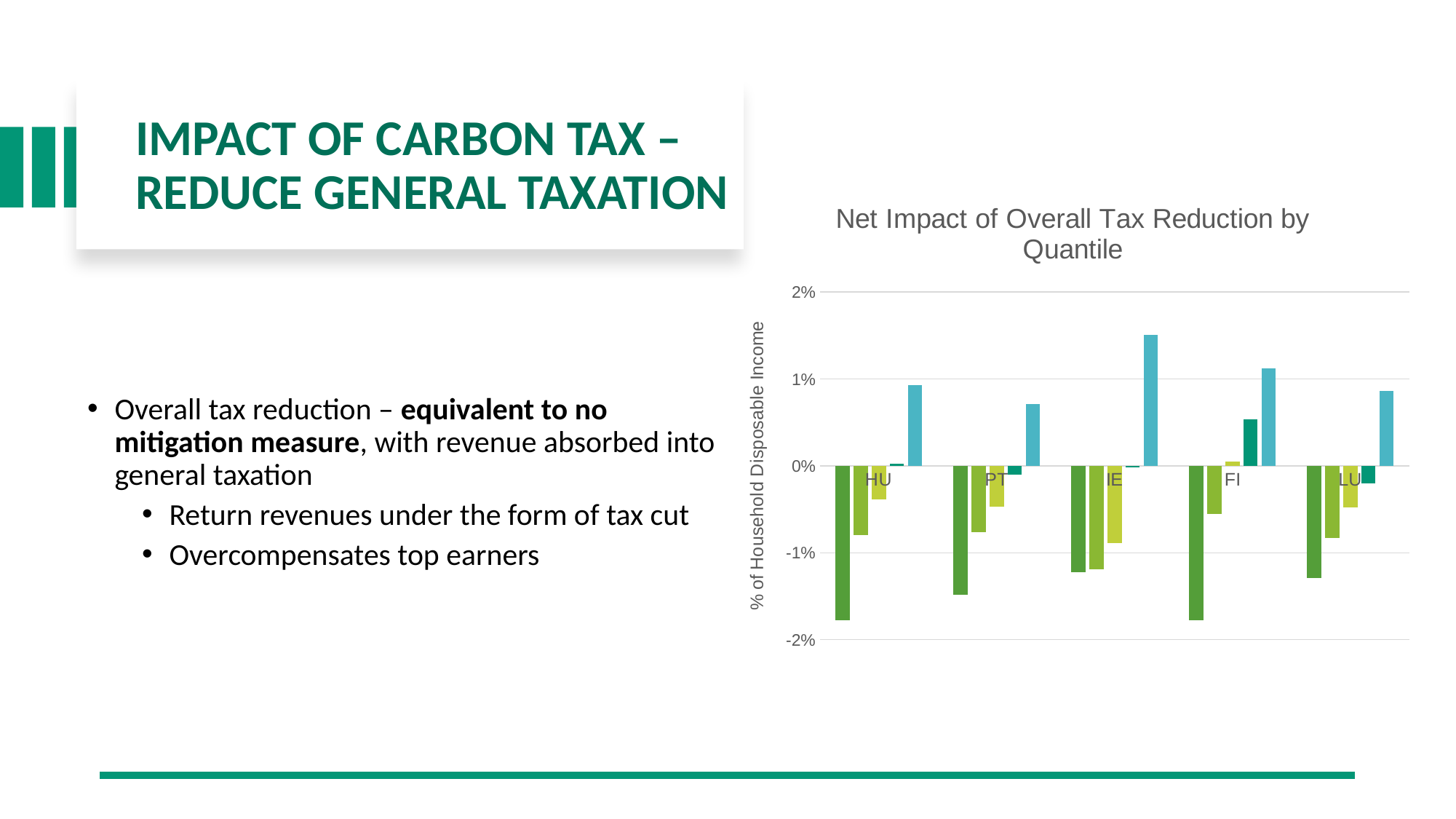
Is the value of the dark green (leftmost) bar for HU greater or less than -1%? less Within the HU group, do the bars rise or fall from left to right? rise What is the label on the vertical axis of the chart? % of Household Disposable Income Which country has the tallest light blue (rightmost) bar? IE Is the value of the light blue (rightmost) bar for PT greater or less than 1%? less Is the value of the dark green (leftmost) bar for LU greater or less than -1%? less What is the title of the chart? Net Impact of Overall Tax Reduction by Quantile Which is larger, the light blue (rightmost) bar for IE or the light blue (rightmost) bar for PT? IE How many bars are plotted for each country in the chart? 5 How many countries are shown on the x axis of the chart? 5 What kind of chart is shown on the slide? bar chart